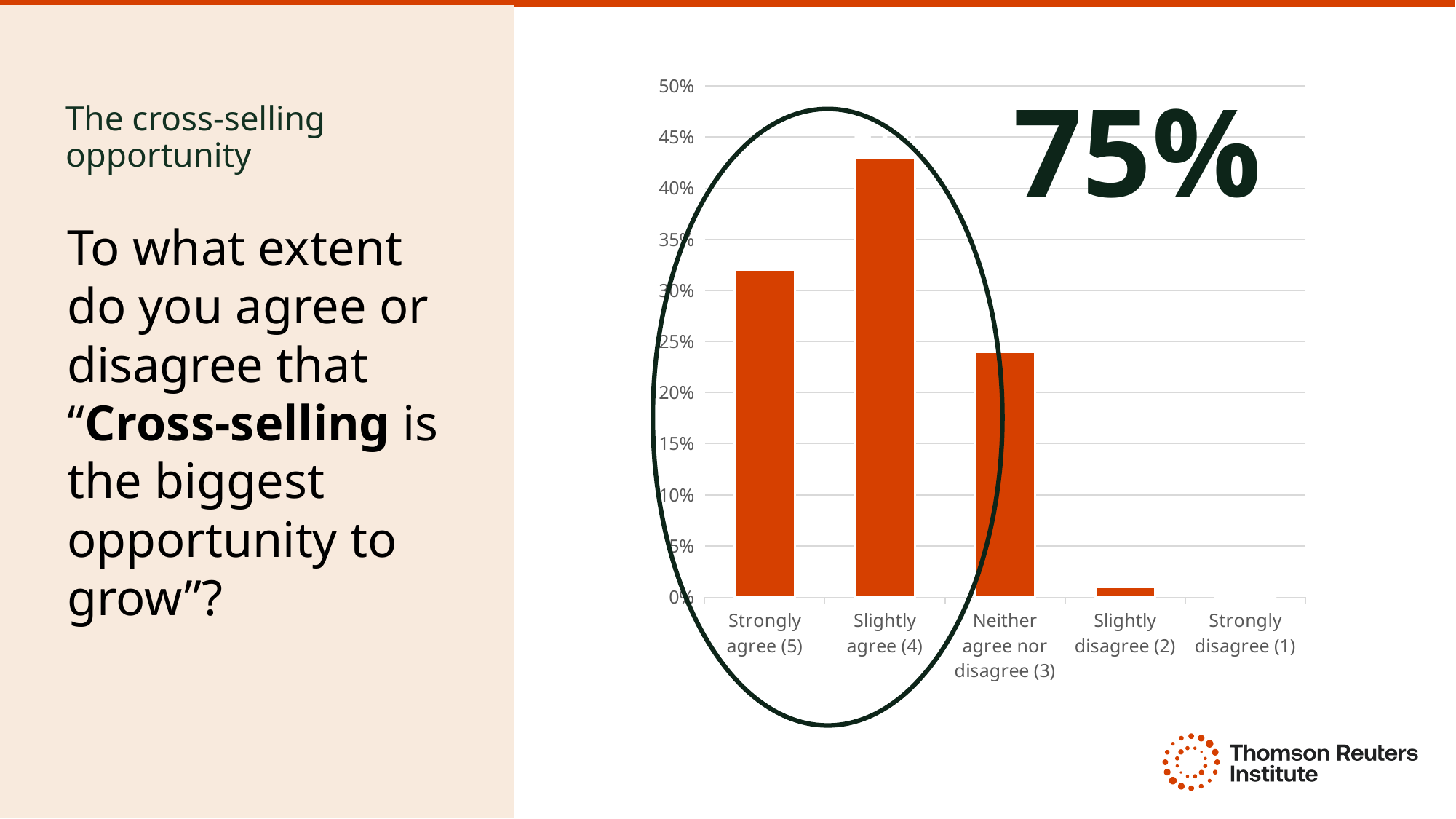
Which response category has the highest bar? Slightly agree (4) Is the value for Slightly agree (4) greater or less than 40%? greater Moving from Slightly agree (4) to Strongly disagree (1) along the x axis, do the values rise or fall? fall Is the value for Slightly disagree (2) greater or less than 5%? less Is the value for Strongly agree (5) greater or less than 25%? greater What kind of chart is shown on the slide? bar chart How many response categories are shown on the x axis of the chart? 5 Which two response categories are circled on the chart? Strongly agree (5) and Slightly agree (4) What large percentage figure is printed next to the chart? 75% Which response category has the lowest value? Strongly disagree (1) Which is larger, the value for Strongly agree (5) or the value for Neither agree nor disagree (3)? Strongly agree (5)